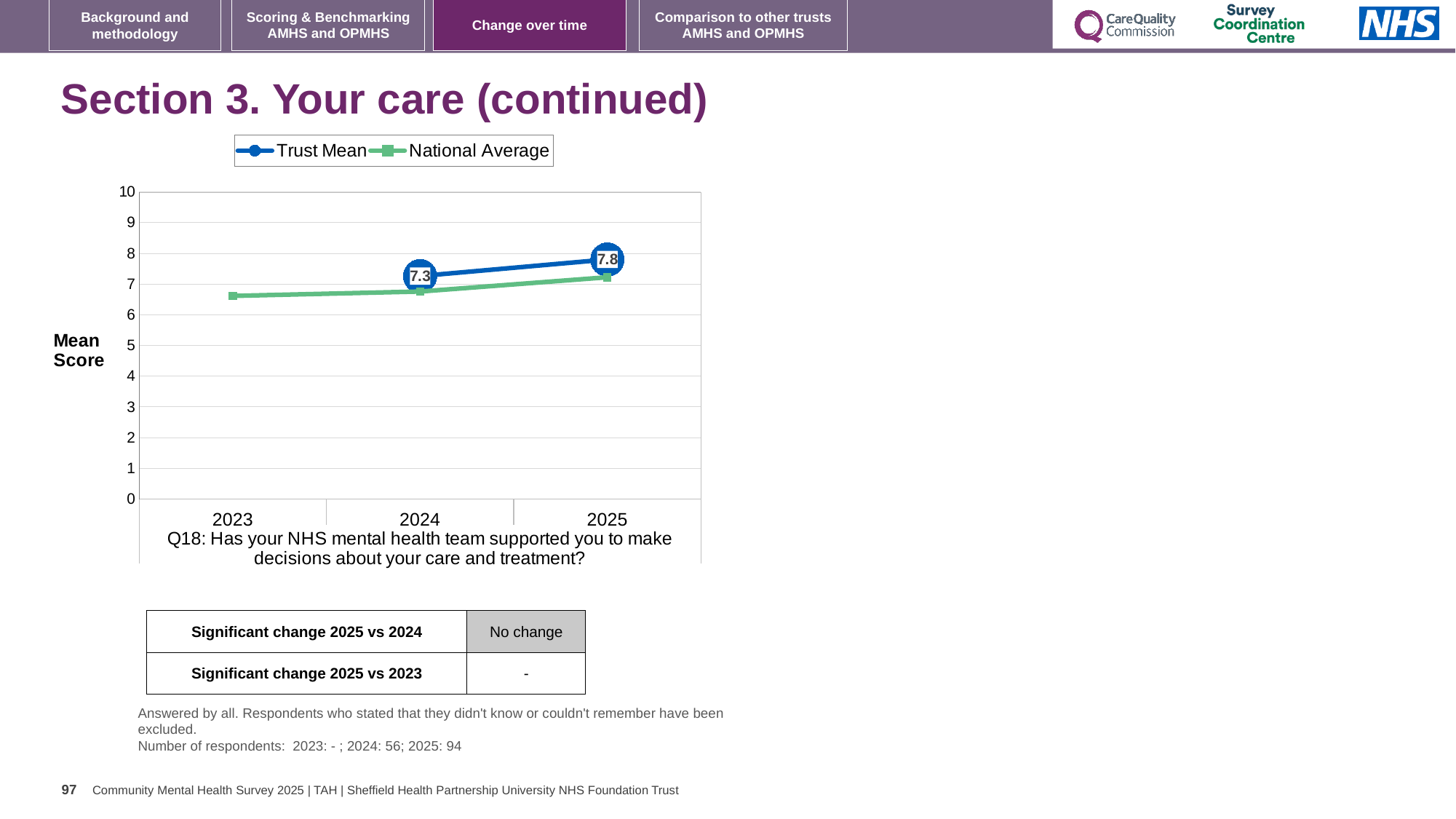
In 2025, which is higher, the Trust Mean or the National Average? Trust Mean Does the Trust Mean rise or fall from 2024 to 2025? rise How many series does the legend list? 2 What is the difference between the Trust Mean scores for 2025 and 2024? 0.5 Is the National Average for 2023 greater or less than 7? less Which year has the higher Trust Mean score, 2024 or 2025? 2025 What is the Trust Mean score for 2025? 7.8 Does the National Average rise or fall from 2023 to 2025? rise How many years are shown on the x axis? 3 Is the National Average for 2025 greater or less than 7? greater What kind of chart is shown on the slide? line chart What is the Trust Mean score for 2024? 7.3